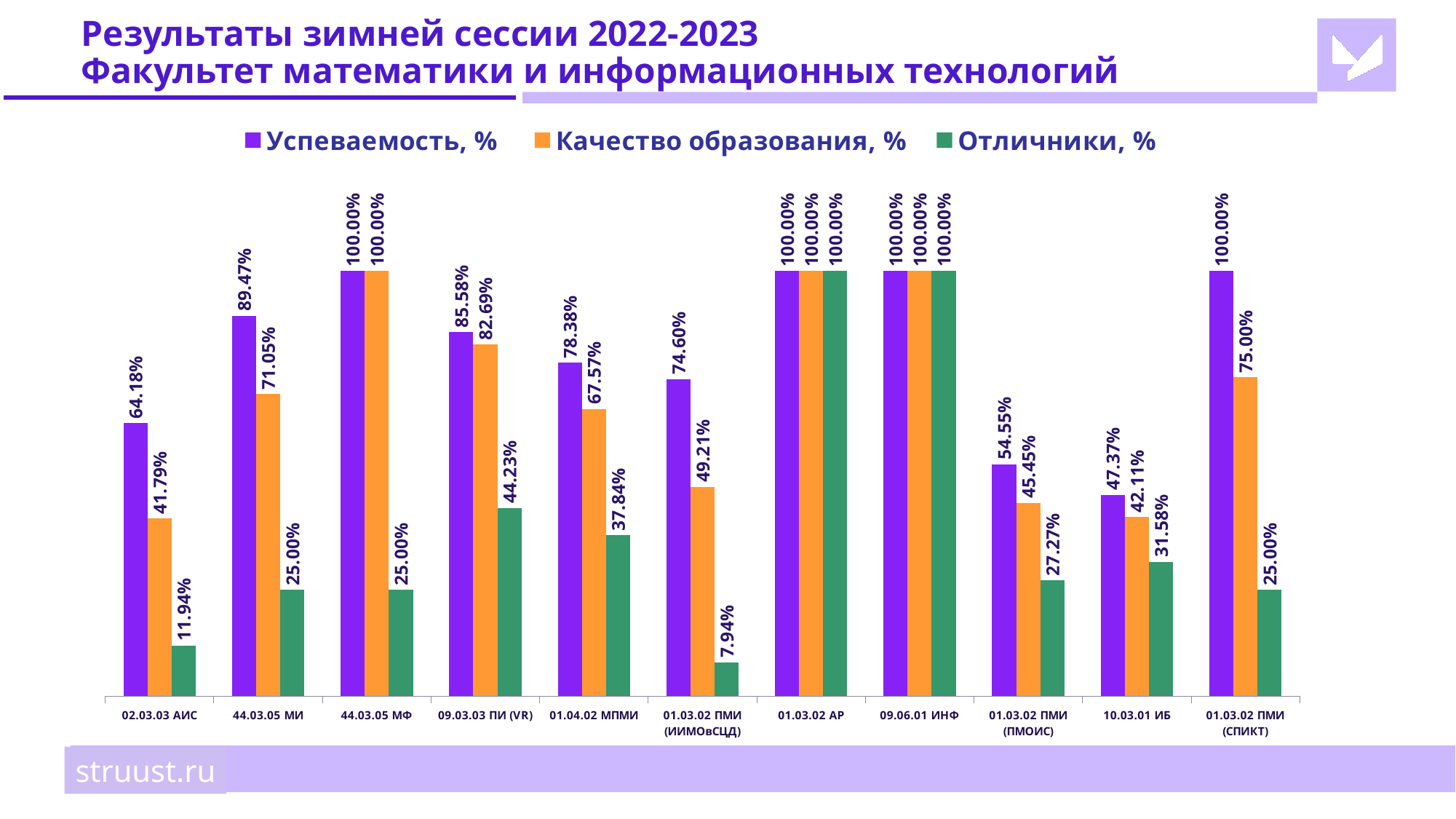
Which category has the lowest value of Отличники, %? 01.03.02 ПМИ (ИИМОвСЦД) What is the value of Качество образования, % for 01.03.02 ПМИ (СПИКТ)? 75.00% Which colour represents the series Отличники, %? Green What is the value of Успеваемость, % for 02.03.03 АИС? 64.18% Which is larger: Отличники, % for 09.03.03 ПИ (VR) or for 01.04.02 МПМИ? 09.03.03 ПИ (VR) Which category has the lowest value of Успеваемость, %? 10.03.01 ИБ What is the value of Качество образования, % for 09.03.03 ПИ (VR)? 82.69% What is the value of Отличники, % for 10.03.01 ИБ? 31.58% How many series does the legend list? 3 What is the difference between Успеваемость, % and Качество образования, % for 02.03.03 АИС? 22.39 percentage points How many categories are shown on the x axis? 11 What kind of chart is shown on the slide? Bar chart